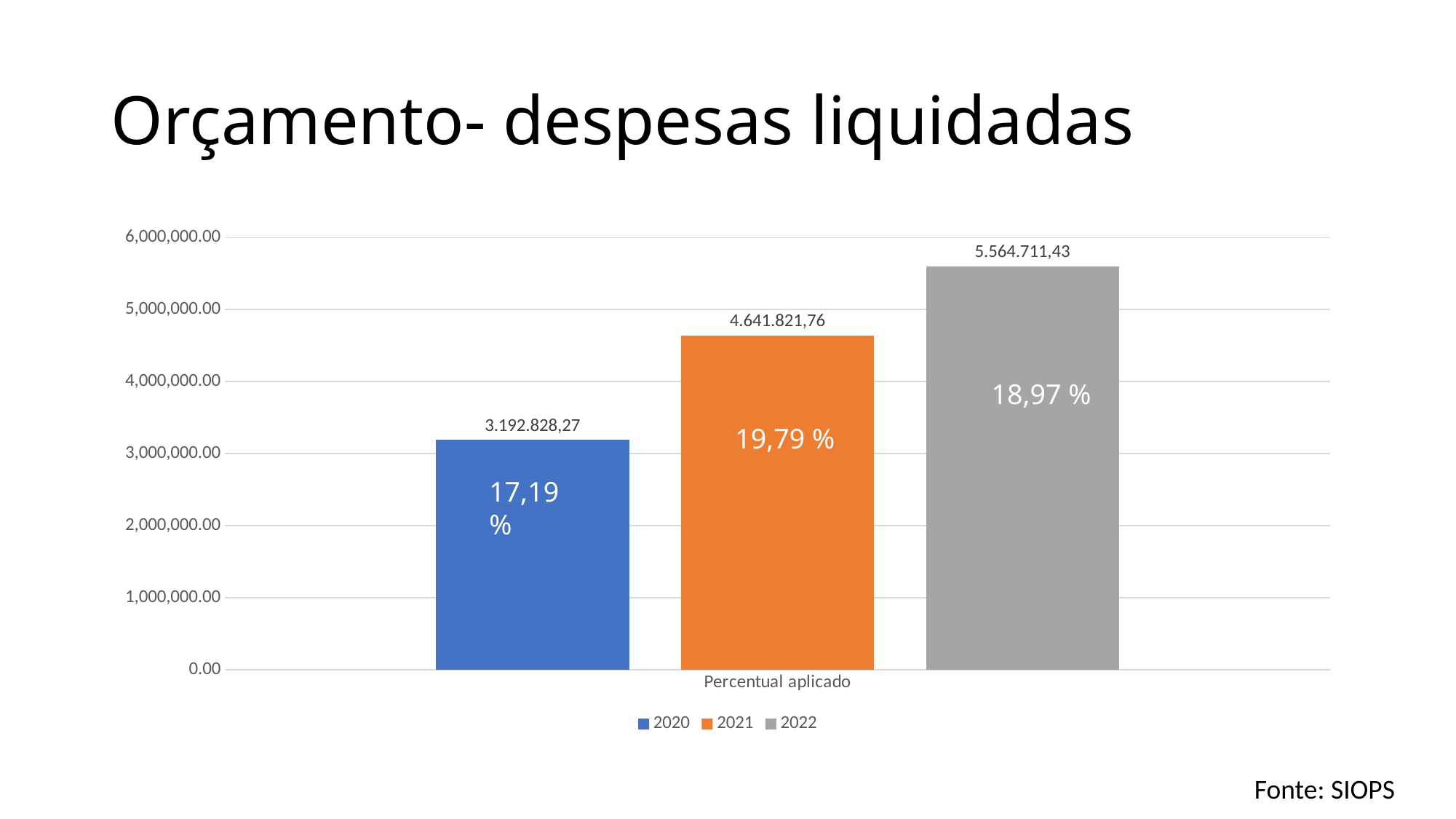
What percentage is printed inside the 2021 bar? 19,79 % What is the value shown for the 2021 bar? 4.641.821,76 What is the value shown for the 2020 bar? 3.192.828,27 What kind of chart is shown on the slide? bar chart How many series does the legend list? 3 Which year has the highest bar? 2022 What is the difference between the 2022 value and the 2021 value? 922.889,67 What percentage is printed inside the 2020 bar? 17,19 % What percentage is printed inside the 2022 bar? 18,97 % What is the value shown for the 2022 bar? 5.564.711,43 Is the value for 2020 greater or less than 3,000,000.00? greater Which year has the lowest bar? 2020